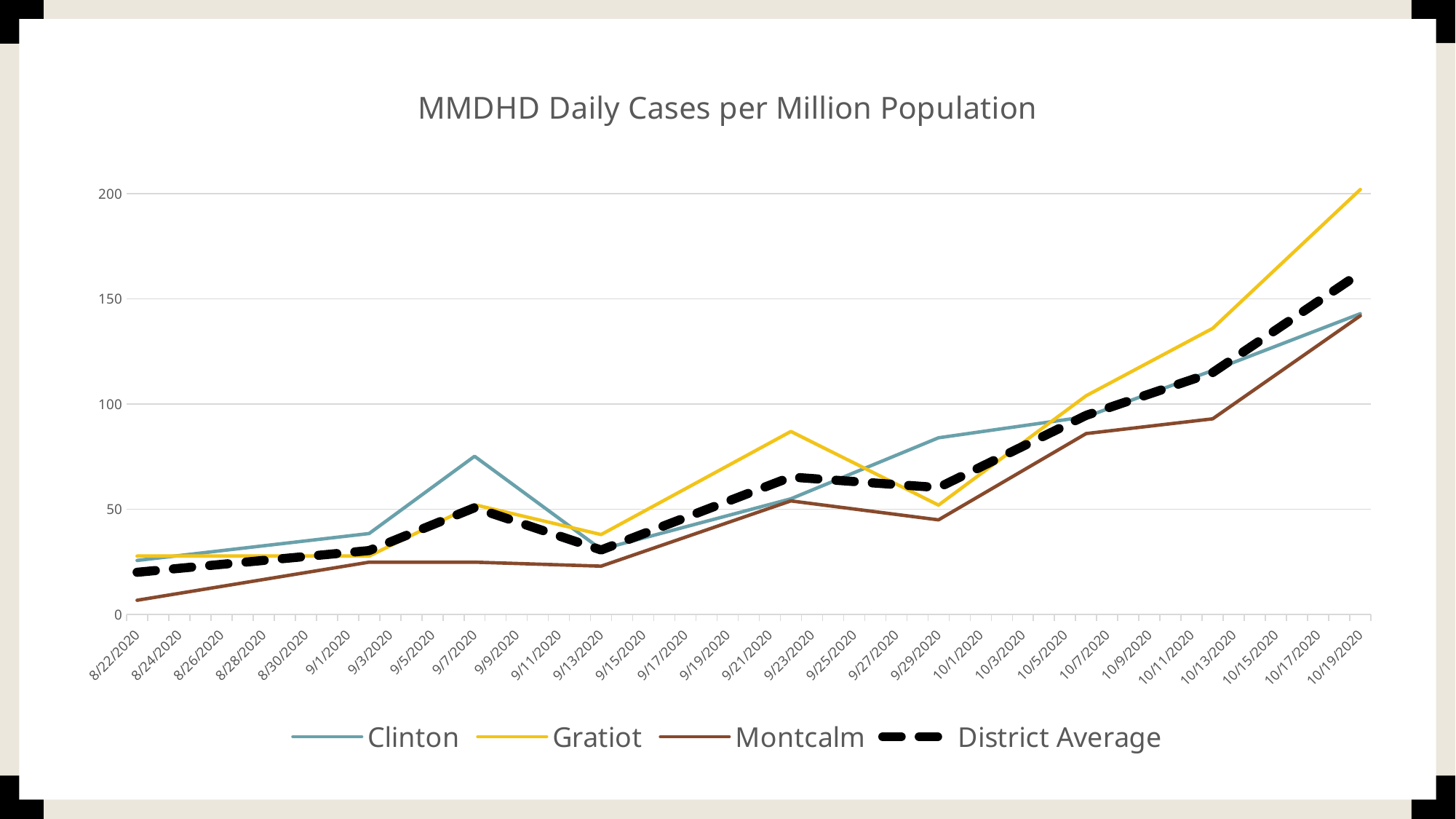
What is the title of the chart? MMDHD Daily Cases per Million Population Which series has the lowest value on 8/22/2020? Montcalm Which series has the highest value on 9/7/2020? Clinton Is the value for Montcalm on 8/22/2020 greater or less than 50? less Which series has the highest value on 10/19/2020? Gratiot Which series is drawn as a dashed black line? District Average Is the value for Gratiot on 10/19/2020 greater or less than 150? greater Does the Gratiot line generally rise or fall from 8/22/2020 to 10/19/2020? rise On 9/29/2020, which is higher, Clinton or Gratiot? Clinton What kind of chart is shown on the slide? line chart Is the value for Clinton on 9/7/2020 greater or less than 50? greater How many series does the legend list? 4